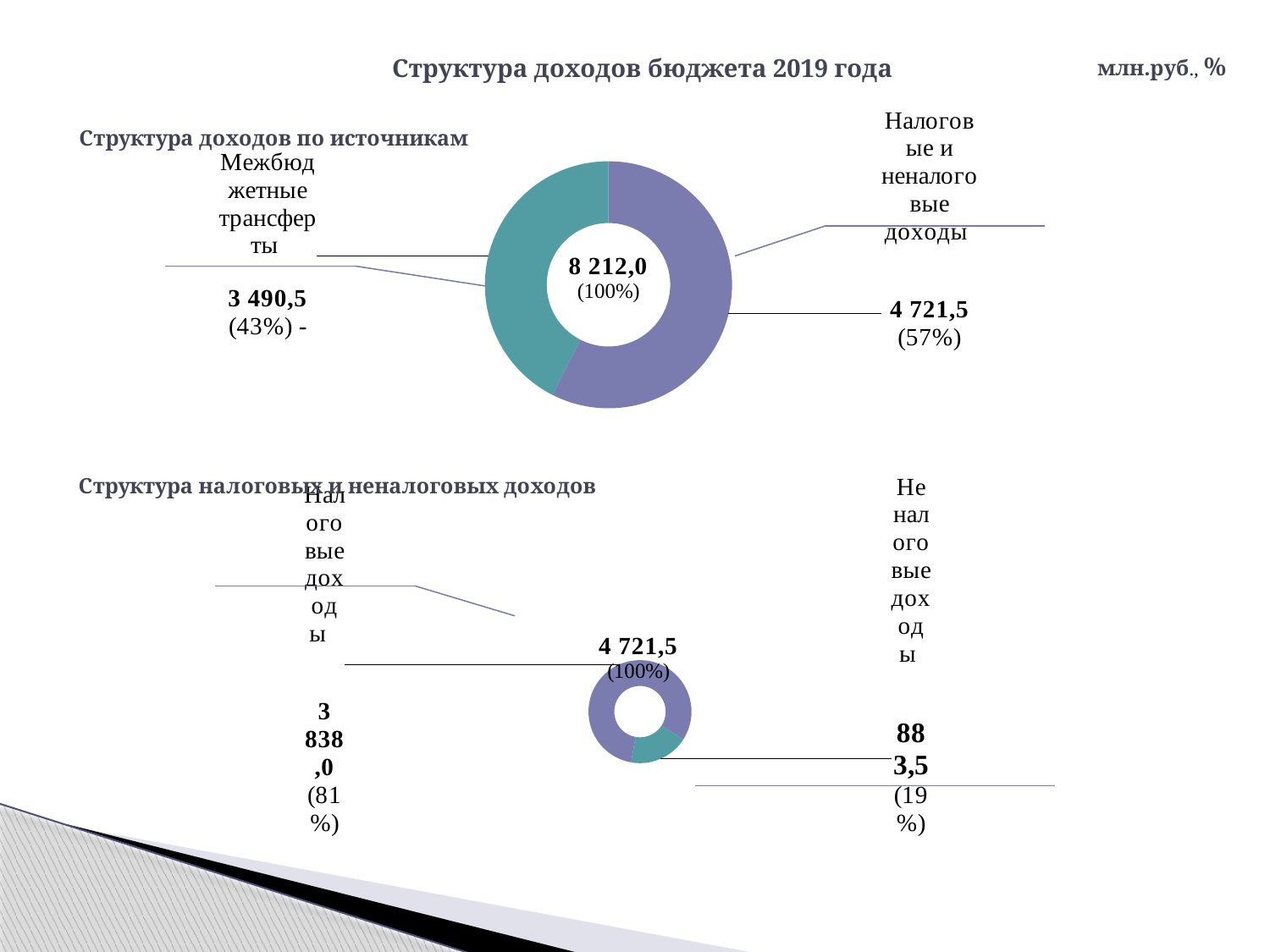
In the chart 'Структура доходов по источникам', what share of the total do Межбюджетные трансферты make up? 43% In the chart 'Структура доходов по источникам', what is the difference between Налоговые и неналоговые доходы and Межбюджетные трансферты? 1 231,0 What kind of chart is used in 'Структура налоговых и неналоговых доходов'? Doughnut chart In the chart 'Структура налоговых и неналоговых доходов', what share of the total do Неналоговые доходы make up? 19% In the chart 'Структура налоговых и неналоговых доходов', what is the value for Налоговые доходы? 3 838,0 In the chart 'Структура доходов по источникам', what total is shown in the centre of the doughnut? 8 212,0 In the chart 'Структура доходов по источникам', what share of the total do Налоговые и неналоговые доходы make up? 57% In the chart 'Структура доходов по источникам', what is the value for Межбюджетные трансферты? 3 490,5 In the chart 'Структура налоговых и неналоговых доходов', what is the value for Неналоговые доходы? 883,5 In the chart 'Структура доходов по источникам', which category is the largest? Налоговые и неналоговые доходы In the chart 'Структура налоговых и неналоговых доходов', which category is the smallest? Неналоговые доходы In the chart 'Структура доходов по источникам', what is the value for Налоговые и неналоговые доходы? 4 721,5